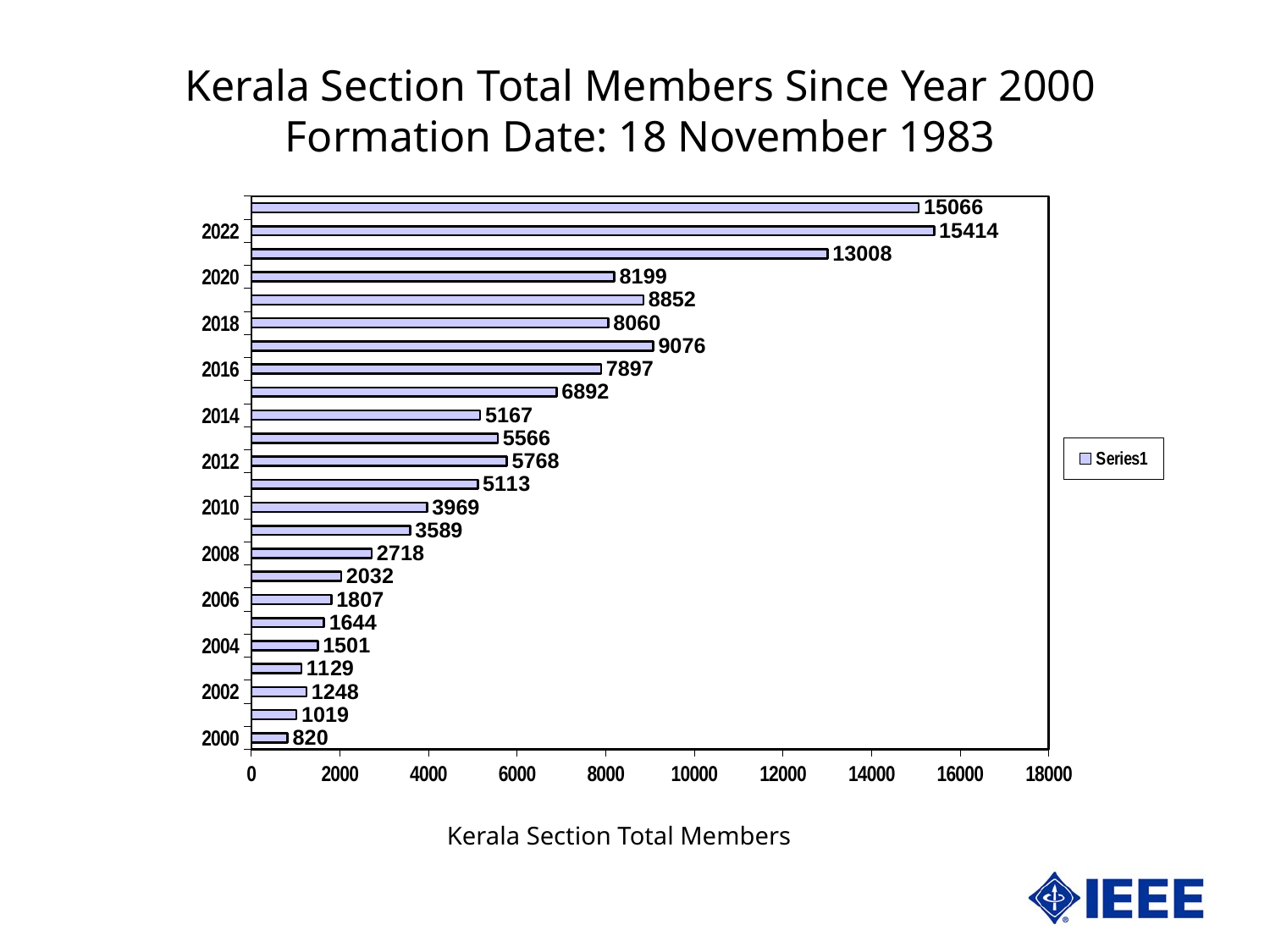
Which is larger, the value for 2018 or the value for 2020? 2020 What is the value for 2000? 820 How many bars are plotted in the chart? 24 What is the value for 2022? 15414 Is the value for 2014 greater or less than 6000? less Which year has the highest number of members? 2022 What kind of chart is shown on the slide? bar chart What is the difference between the values for 2022 and 2020? 7215 What is the value for 2010? 3969 Which year has the lowest number of members? 2000 What is the value for 2016? 7897 How many series does the legend list? 1